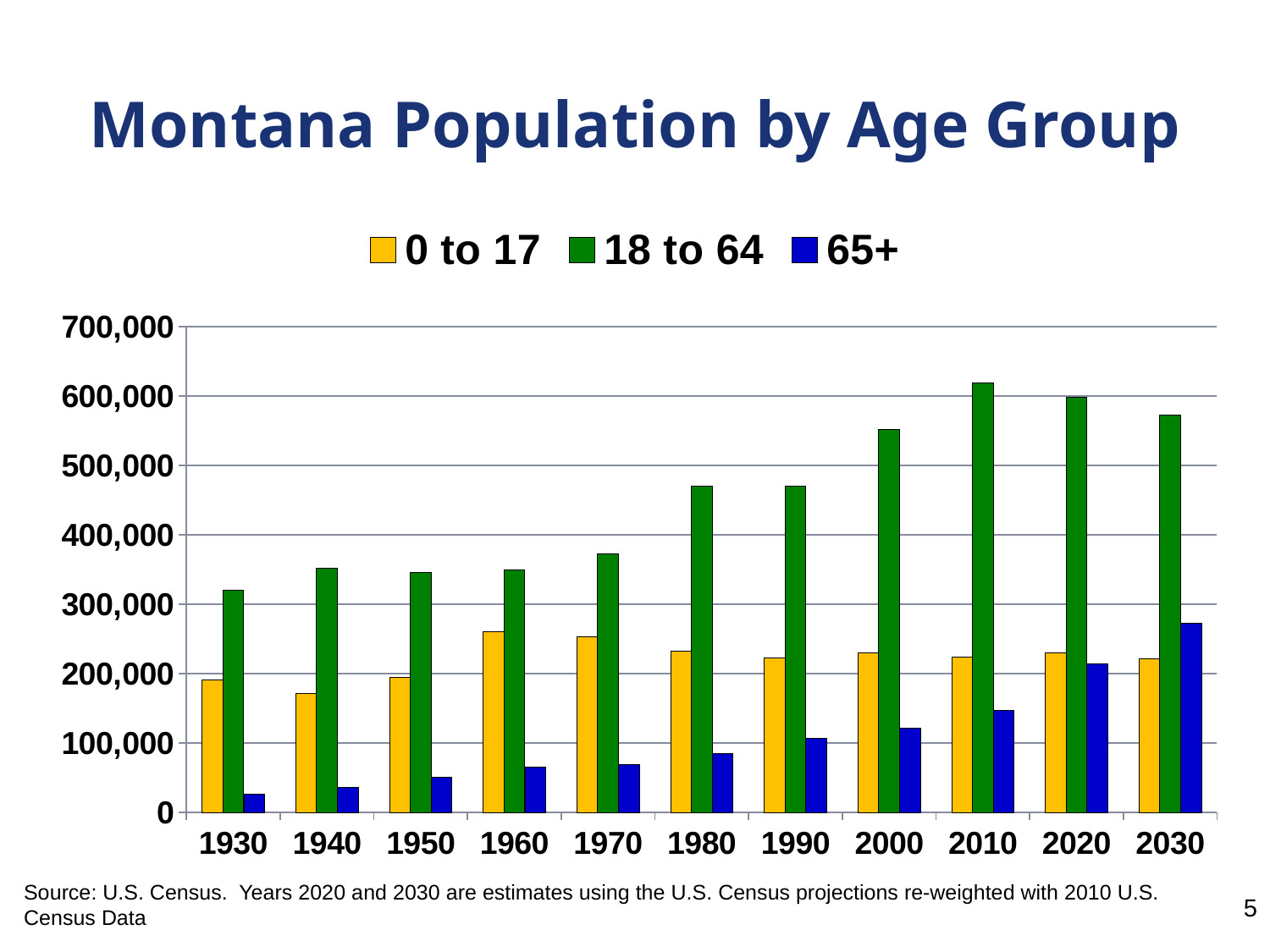
In which year is the 65+ population highest? 2030 What colour represents the 65+ series? blue What kind of chart is shown on the slide? bar chart How many series does the legend list? 3 In which year is the 65+ population lowest? 1930 In which year is the 18 to 64 population highest? 2010 Does the 65+ population rise or fall from 1930 to 2030? rise Is the 18 to 64 value for 2010 greater or less than 600,000? greater In which year is the 0 to 17 population lowest? 1940 Is the 65+ value for 2030 greater or less than 300,000? less Which is larger, the 0 to 17 value for 1960 or for 1940? 1960 How many years are shown on the x axis? 11